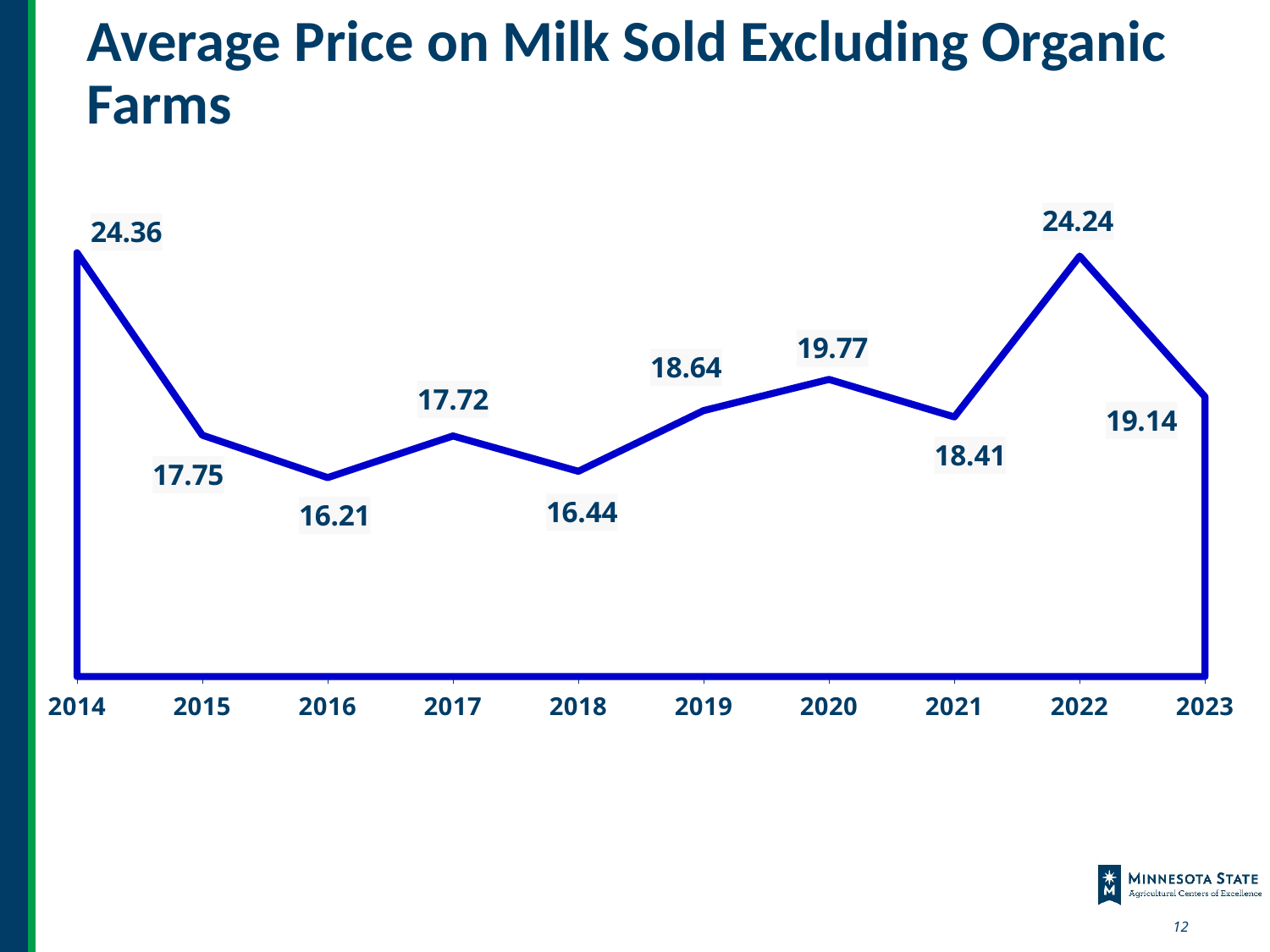
What is the difference between the values for 2022 and 2021? 5.83 What is the average price on milk sold for 2014? 24.36 Which year has the highest average price on milk sold? 2014 What kind of chart is shown on the slide? Line chart What is the value shown for 2022? 24.24 Which year has a higher value, 2020 or 2019? 2020 Does the value rise or fall from 2018 to 2020? Rise What is the value shown for 2023? 19.14 How many years are plotted on the chart? 10 What is the value shown for 2018? 16.44 What is the difference between the values for 2014 and 2015? 6.61 Which year has the lowest average price on milk sold? 2016